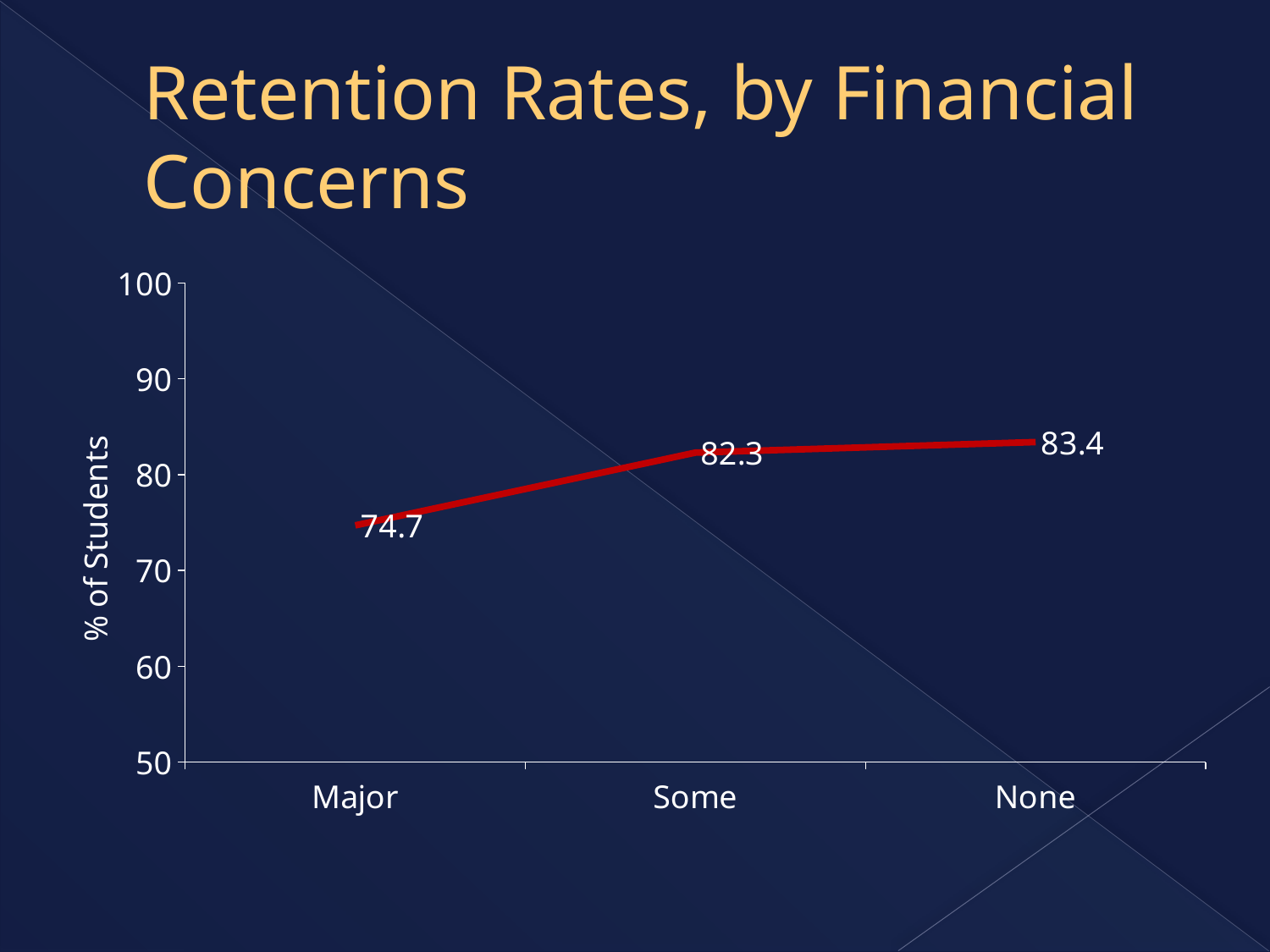
What is the retention rate for students with Major financial concerns? 74.7 Which financial-concern category has the lowest retention rate? Major What is the difference in retention rate between the None and Major categories? 8.7 What kind of chart is shown on the slide? line chart How many financial-concern categories are plotted on the chart? 3 What is the difference in retention rate between the Some and Major categories? 7.6 Which financial-concern category has the highest retention rate? None What is the retention rate for students with no (None) financial concerns? 83.4 Is the retention rate for Major financial concerns greater or less than 80? less Which has a higher retention rate, Major or Some financial concerns? Some What is the retention rate for students with Some financial concerns? 82.3 Do retention rates rise or fall moving from Major to None along the x axis? rise